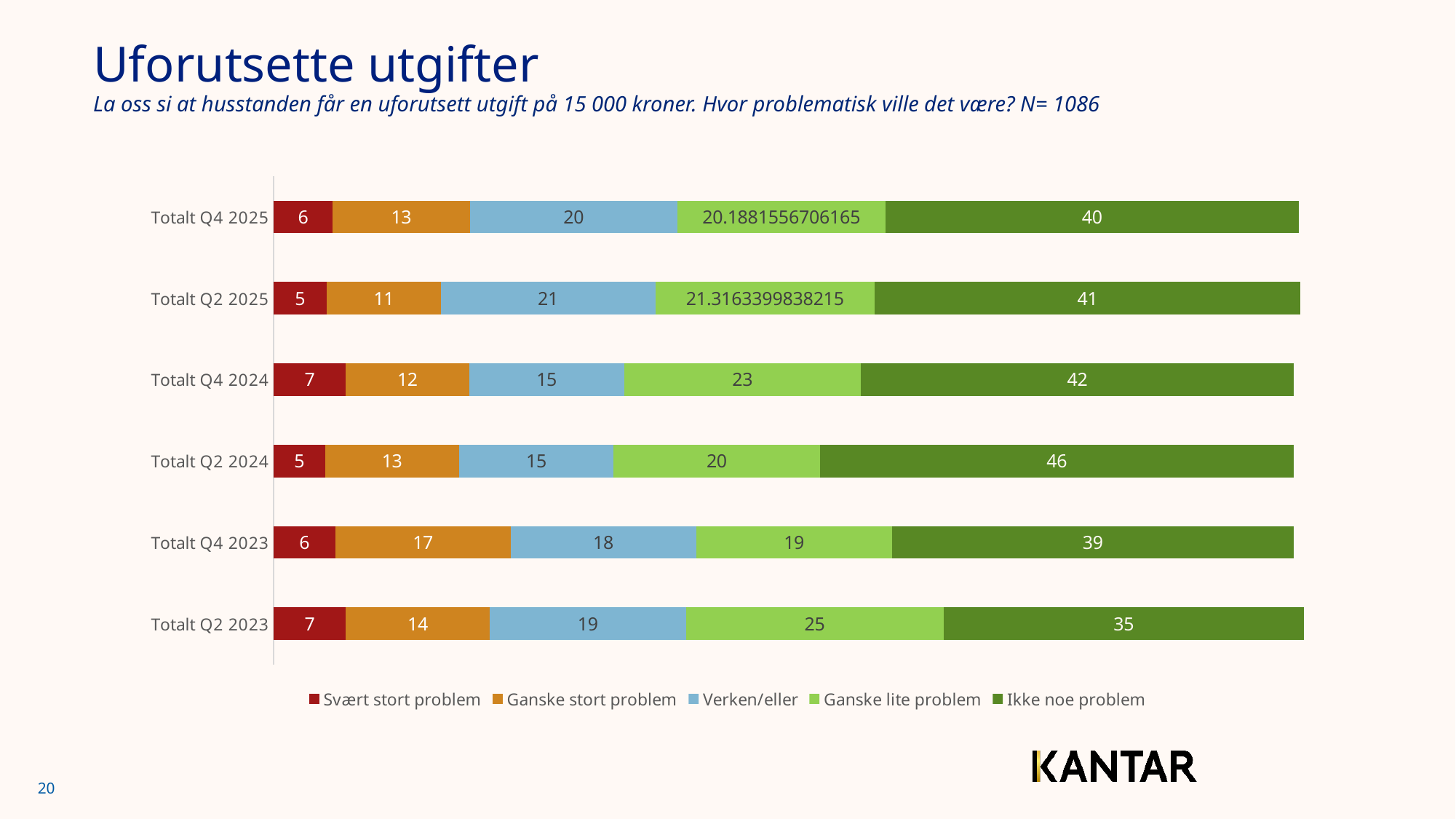
What is the value for "Verken/eller" in Totalt Q2 2025? 21 What is the value for "Ganske lite problem" in Totalt Q4 2025? 20.1881556706165 What is the value for "Ganske stort problem" in Totalt Q4 2023? 17 What is the total of the stacked bar for Totalt Q2 2023? 100 Which category has the highest value for "Ikke noe problem"? Totalt Q2 2024 How many categories are shown on the chart? 6 Which is larger: the "Ganske stort problem" value for Totalt Q4 2023 or for Totalt Q2 2025? Totalt Q4 2023 What is the difference between the "Ikke noe problem" values for Totalt Q2 2024 and Totalt Q2 2023? 11 Which category has the lowest value for "Ikke noe problem"? Totalt Q2 2023 What is the value for "Ikke noe problem" in Totalt Q2 2024? 46 How many series does the legend list? 5 Which category has the highest value for "Ganske lite problem"? Totalt Q2 2023